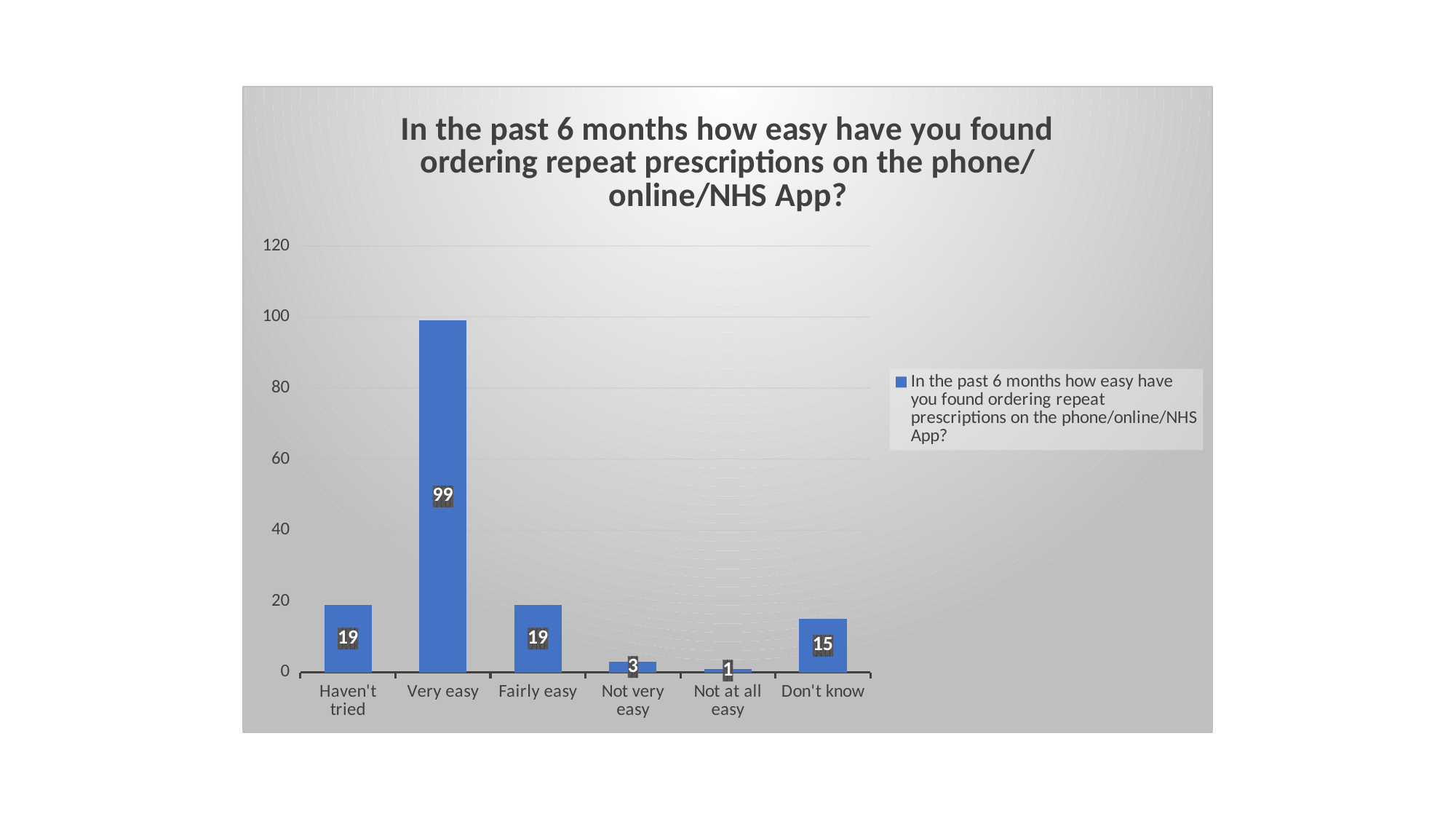
How many series does the legend list? 1 What is the difference between the values for "Very easy" and "Fairly easy"? 80 What is the value for "Very easy"? 99 What is the value for "Not very easy"? 3 What kind of chart is shown on the slide? Bar chart How many categories are shown on the x axis? 6 What is the value for "Haven't tried"? 19 Which category has the highest value? Very easy Which category has the lowest value? Not at all easy What is the value for "Don't know"? 15 What is the difference between the values for "Don't know" and "Not very easy"? 12 Which is larger, the value for "Don't know" or the value for "Fairly easy"? Fairly easy